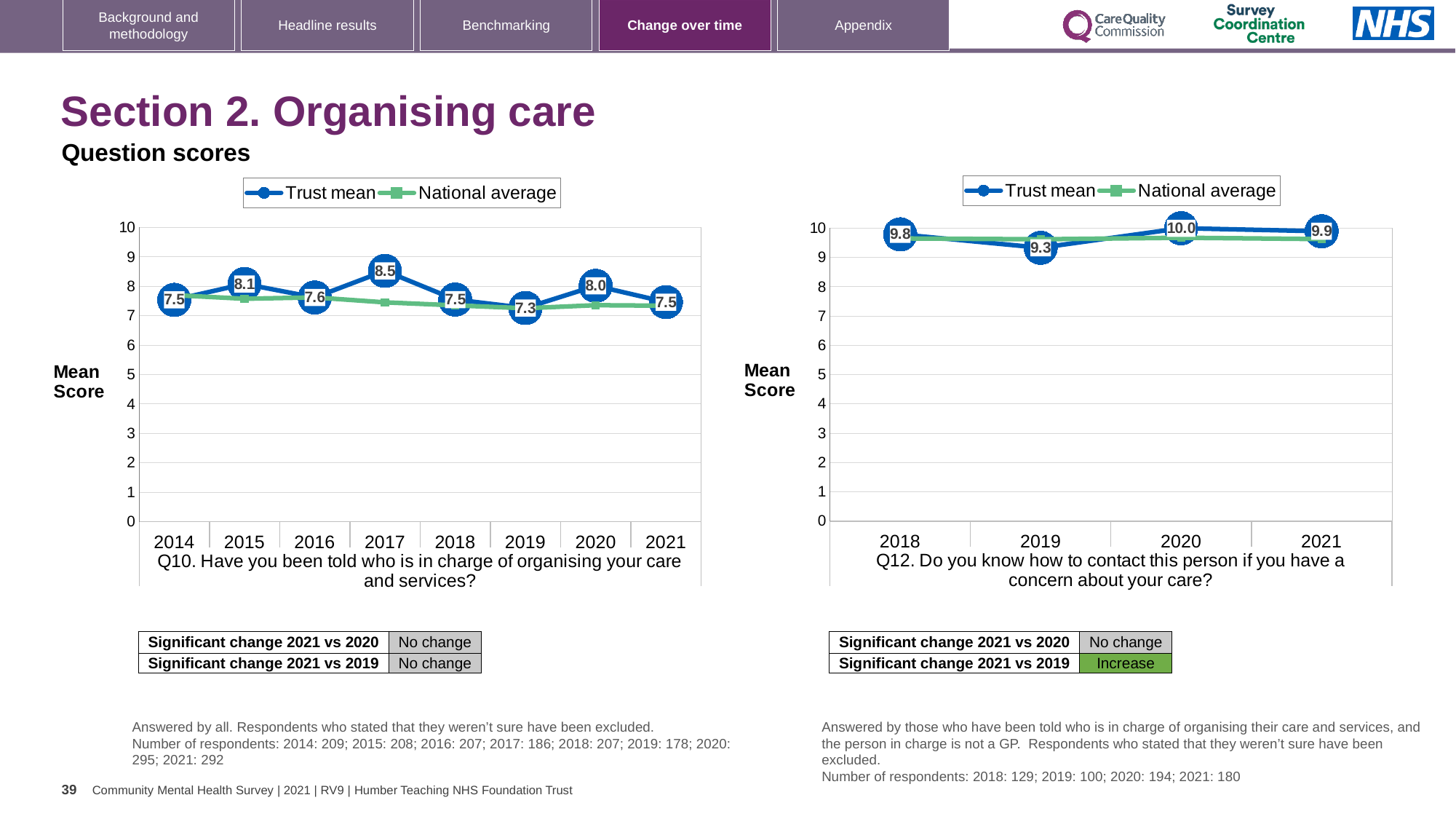
In the Q10 chart on the left, is the Trust mean higher in 2015 or in 2016? 2015 In the Q12 chart on the right, is the National average for 2019 greater or less than 9? greater In the Q12 chart on the right, what is the Trust mean for 2020? 10.0 In the Q10 chart on the left, what is the Trust mean for 2017? 8.5 In the Q10 chart on the left, what is the Trust mean for 2019? 7.3 In the Q12 chart on the right, which year has the lowest Trust mean? 2019 In the Q10 chart on the left, what is the difference between the Trust mean in 2017 and in 2019? 1.2 How many series does the legend of the Q10 chart on the left list? 2 In the Q12 chart on the right, what is the difference between the Trust mean in 2020 and in 2019? 0.7 What kind of chart is the Q10 chart on the left? Line chart How many years are shown on the x axis of the Q12 chart on the right? 4 In the Q10 chart on the left, which year has the highest Trust mean? 2017